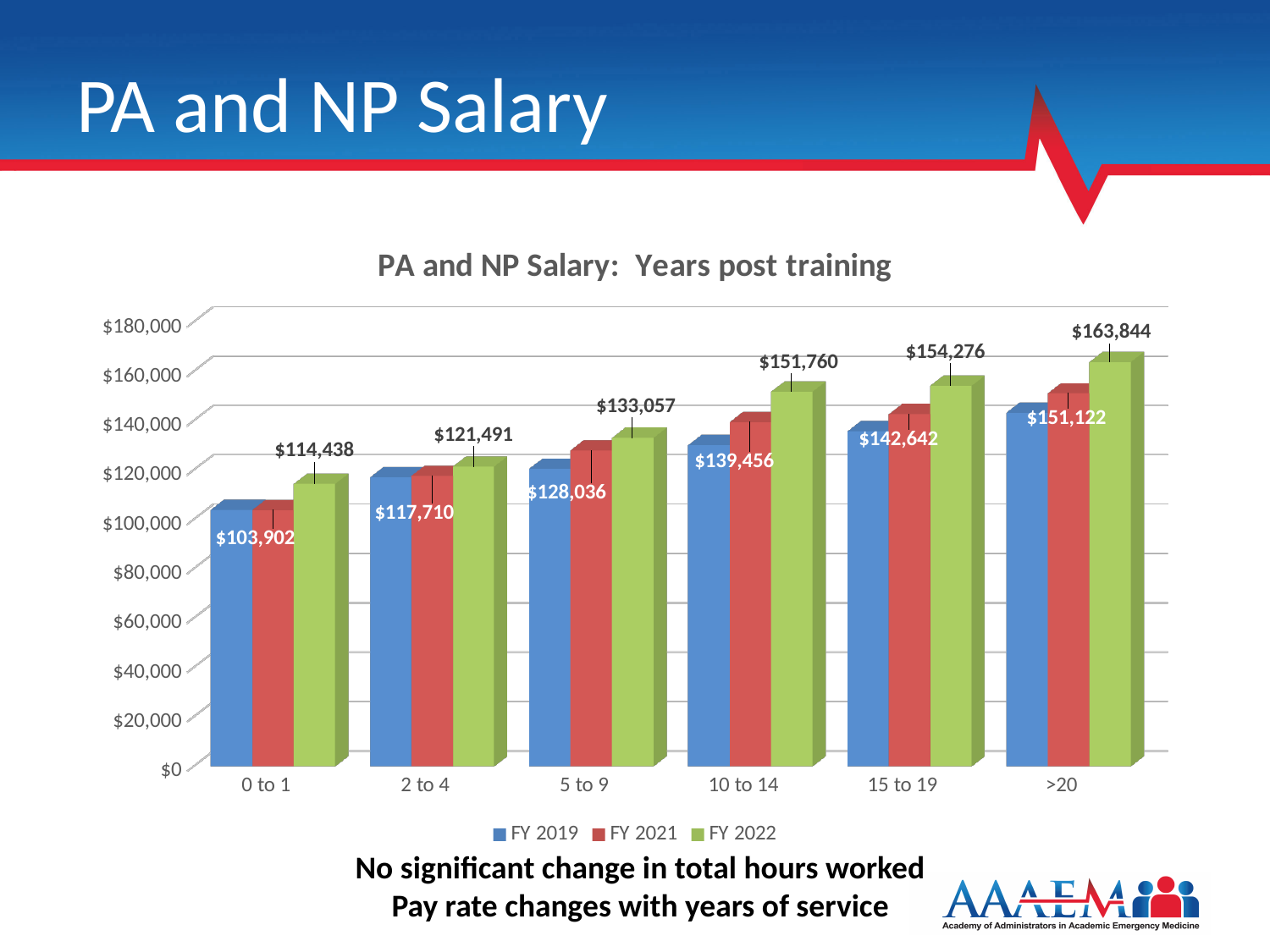
Do the FY 2022 values rise or fall as years post training increase along the x axis? rise How many series does the legend list? 3 How many years-post-training categories are shown on the x axis? 6 Which is larger: the FY 2019 value for >20 years or the FY 2022 value for 10 to 14 years? FY 2022 value for 10 to 14 years What is the FY 2022 value for the 10 to 14 years category? $151,760 Which years-post-training category has the highest FY 2022 salary? >20 What is the FY 2022 value for the >20 years post training category? $163,844 Which years-post-training category has the lowest FY 2019 salary? 0 to 1 Is the FY 2021 value for the >20 years category greater or less than $140,000? greater